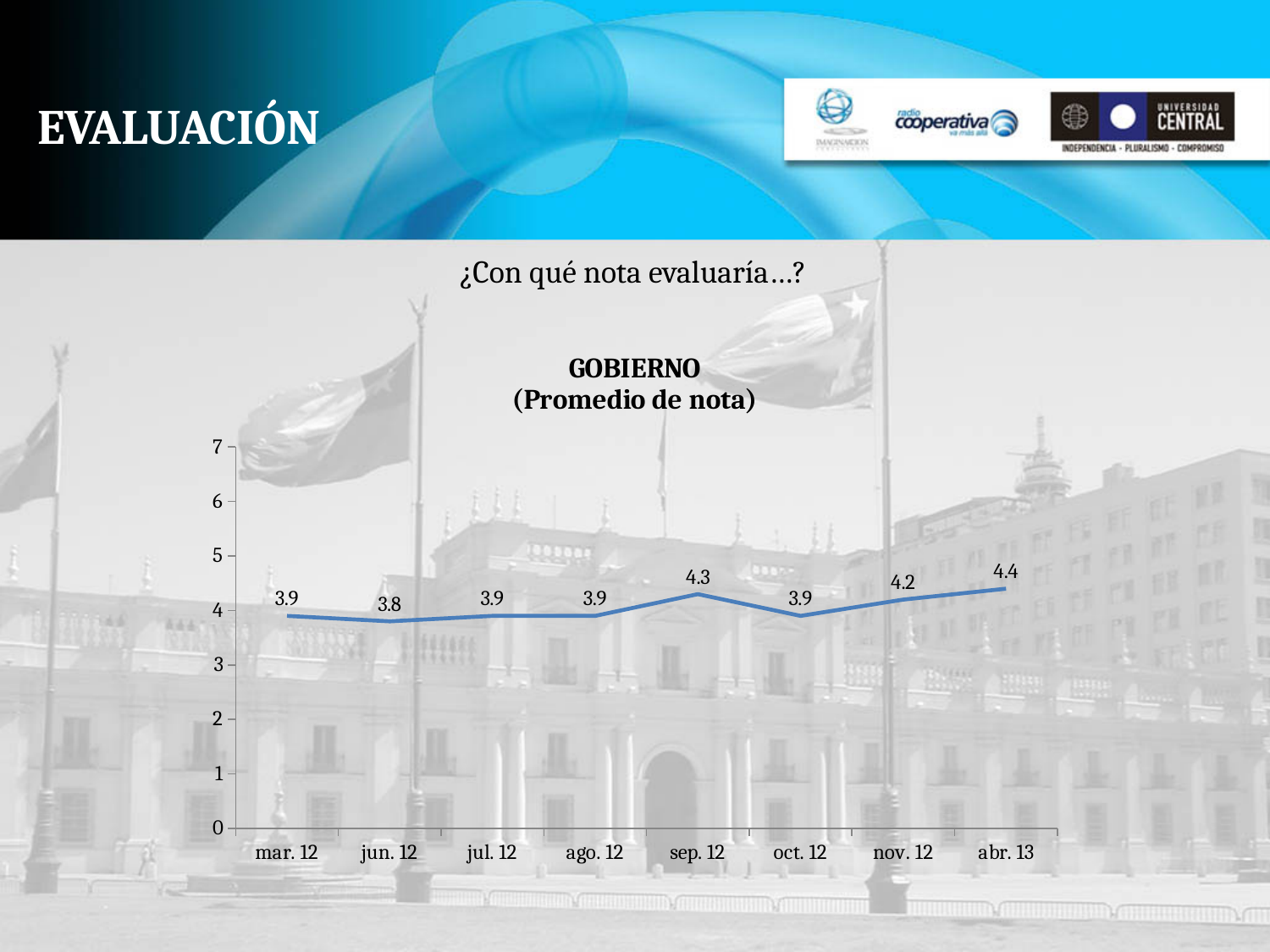
What is the value for sep. 12? 4.3 What is the difference between the values for abr. 13 and jun. 12? 0.6 Which is larger, the value for sep. 12 or the value for oct. 12? sep. 12 What is the value for abr. 13? 4.4 What kind of chart is shown? line chart What is the value for jun. 12? 3.8 Which period has the highest value? abr. 13 What is the value for mar. 12? 3.9 How many periods are shown on the x axis? 8 What is the title of the chart? GOBIERNO (Promedio de nota) Which period has the lowest value? jun. 12 Is the value for nov. 12 greater or less than 5? less